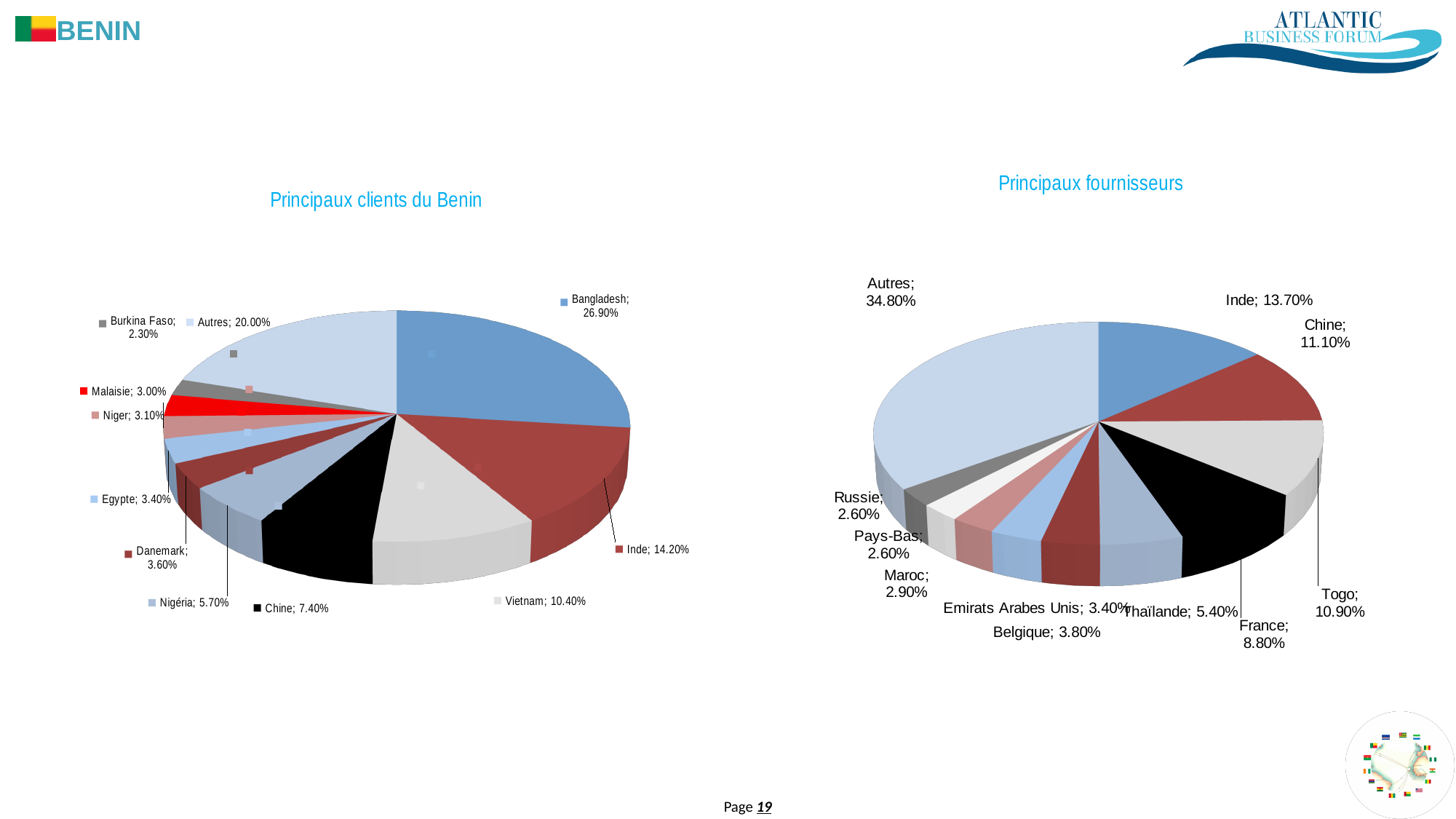
In the 'Principaux fournisseurs' chart, which is larger, Inde or Chine? Inde In the 'Principaux clients du Benin' chart, how many slices does the pie have? 11 In the 'Principaux clients du Benin' chart, what is the value for Vietnam? 10.40% In the 'Principaux clients du Benin' chart, which category has the smallest share? Burkina Faso In the 'Principaux fournisseurs' chart, what is the difference between the shares of Thaïlande and Belgique? 1.60% In the 'Principaux fournisseurs' chart, what share does France have? 8.80% In the 'Principaux clients du Benin' chart, what is the difference between the shares of Inde and Chine? 6.80% In the 'Principaux fournisseurs' chart, what is the value for Togo? 10.90% What type of chart is used for 'Principaux fournisseurs'? Pie chart In the 'Principaux fournisseurs' chart, which category has the largest share? Autres In the 'Principaux clients du Benin' chart, which named country (excluding Autres) has the largest share? Bangladesh In the 'Principaux clients du Benin' chart, what share does Bangladesh have? 26.90%